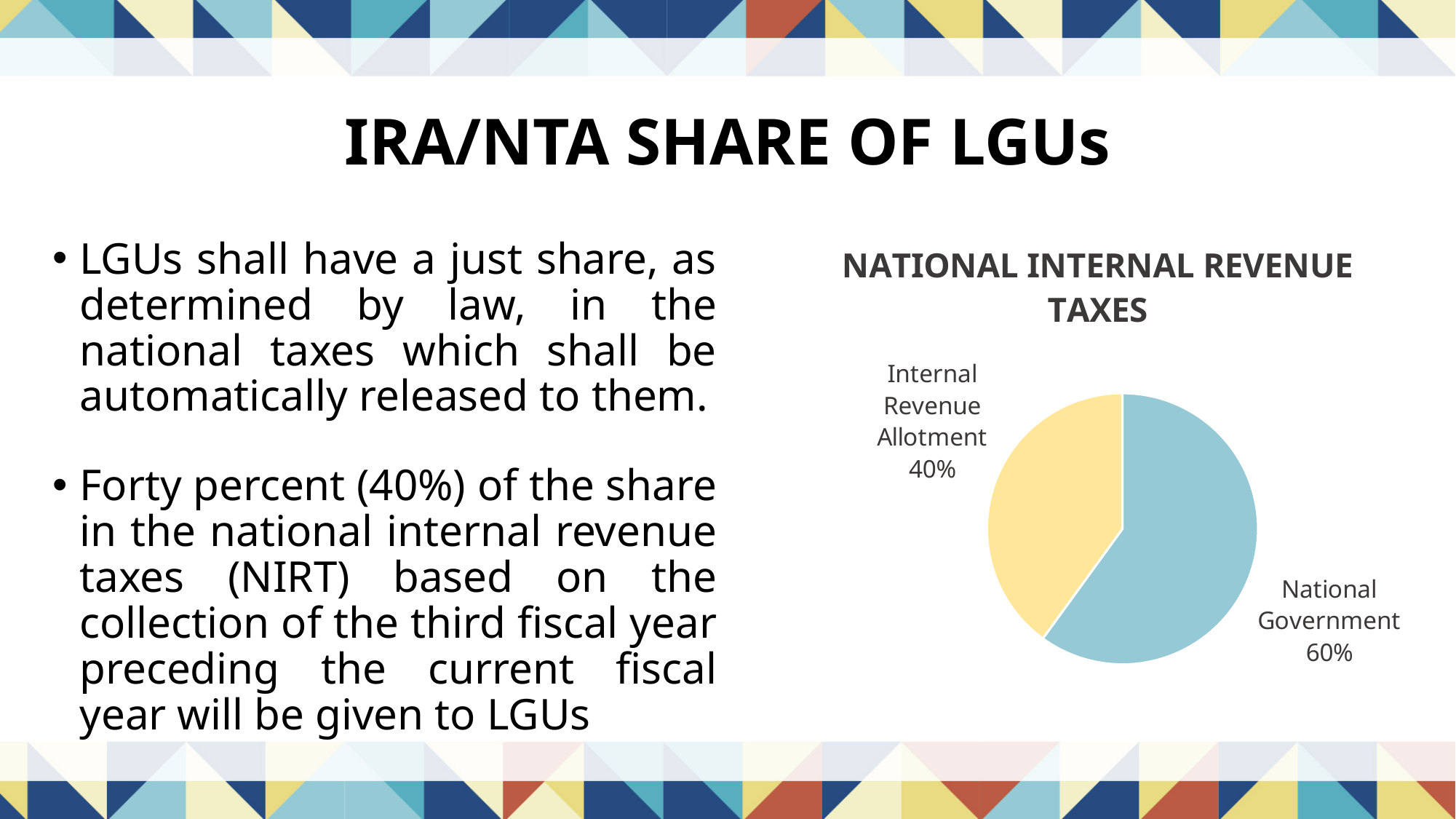
What share of the pie is labelled National Government? 60% What share of the pie is labelled Internal Revenue Allotment? 40% Which slice of the pie is the largest? National Government What is the total of the two slices shown in the pie chart? 100% What kind of chart is shown on the slide? pie chart Which slice of the pie is the smallest? Internal Revenue Allotment What is the title of the chart? NATIONAL INTERNAL REVENUE TAXES What colour is the Internal Revenue Allotment slice? yellow What is the difference in percentage points between the National Government share and the Internal Revenue Allotment share? 20% Which is larger, the National Government share or the Internal Revenue Allotment share? National Government How many slices does the pie chart have? 2